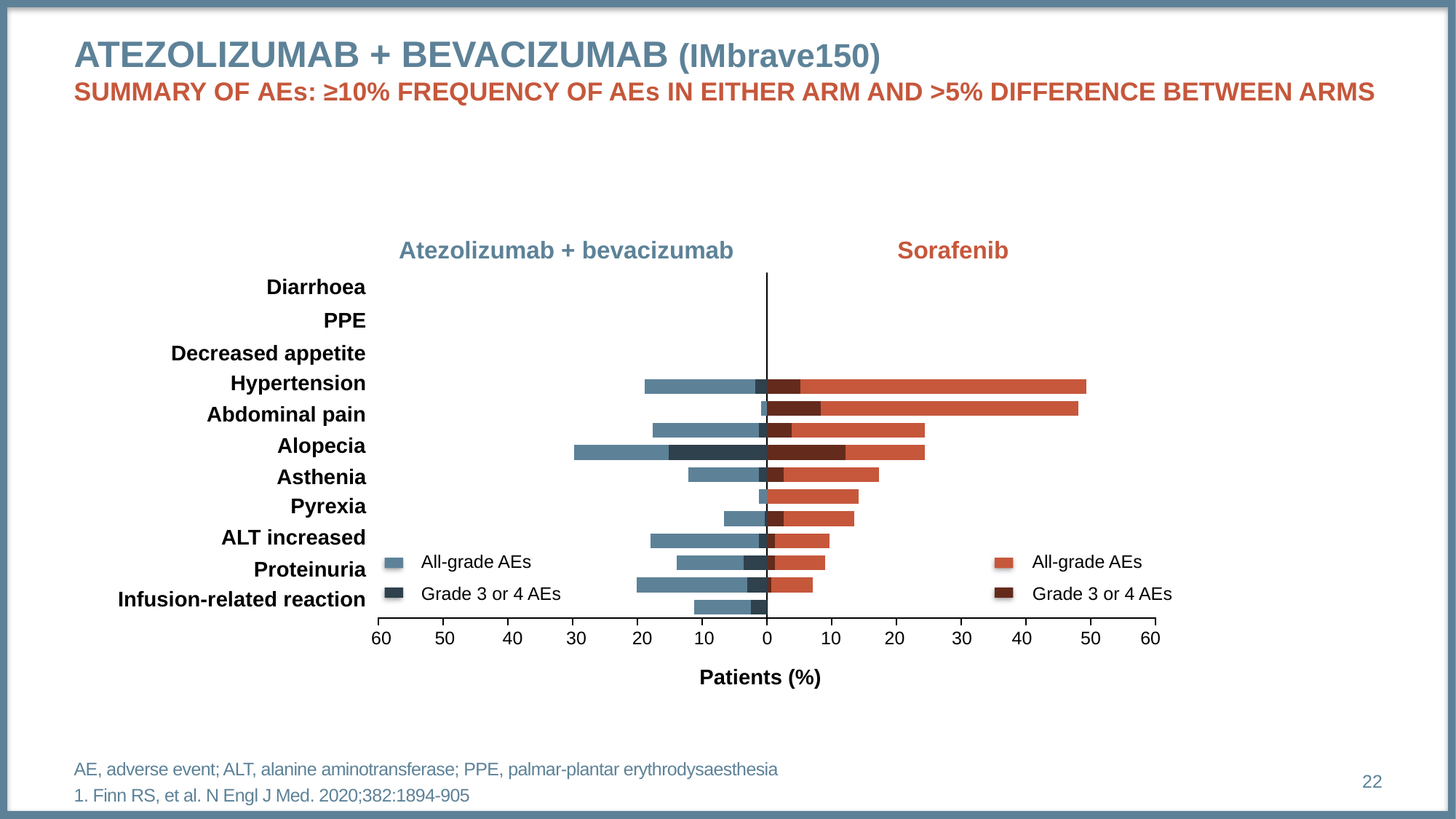
What is the maximum value shown on the horizontal axis at either end? 60 How many adverse event categories are listed on the chart's vertical axis? 11 Is the largest all-grade AE frequency shown for the Sorafenib arm greater or less than 40? greater Is the largest all-grade AE frequency shown for the Atezolizumab + bevacizumab arm greater or less than 40? less How many entries does the legend for the Sorafenib arm list? 2 Which arm has the longer maximum all-grade AE bar, Atezolizumab + bevacizumab or Sorafenib? Sorafenib What is the title of the chart's horizontal axis? Patients (%) What kind of chart is shown on the slide? Bar chart Which treatment arm is plotted on the left side of the chart? Atezolizumab + bevacizumab